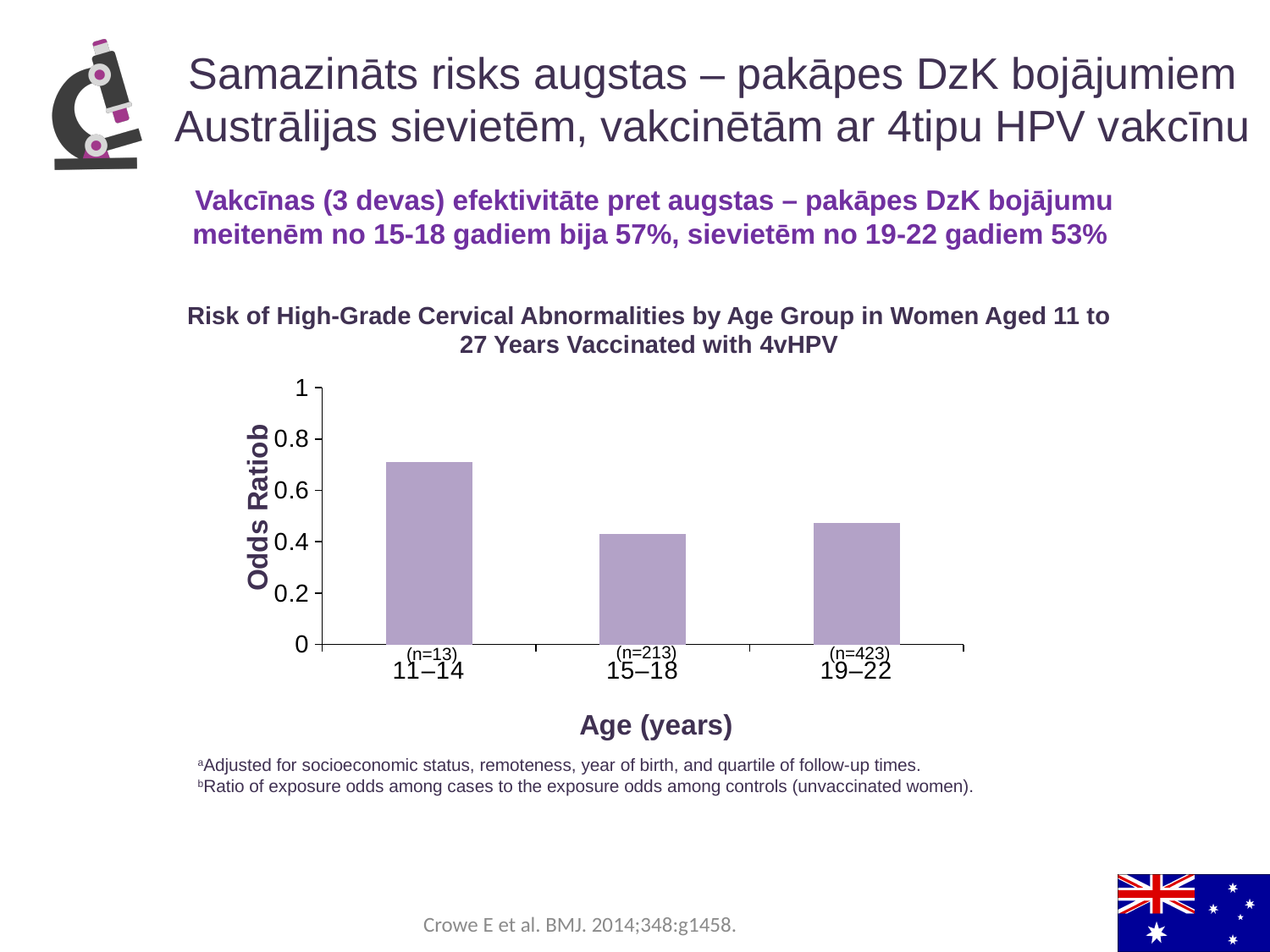
Which has the larger odds ratio, the 11–14 age group or the 19–22 age group? 11–14 Is the odds ratio for the 19–22 age group greater or less than 0.4? greater What kind of chart is shown on the slide? bar chart Is the odds ratio for the 19–22 age group greater or less than 0.6? less How many age groups are plotted in the chart? 3 What sample size (n) is shown for the 19–22 age group? n=423 Which age group has the highest odds ratio? 11–14 What is the label of the vertical axis of the chart? Odds Ratio Is the odds ratio for the 15–18 age group greater or less than 0.6? less Which has the larger odds ratio, the 11–14 age group or the 15–18 age group? 11–14